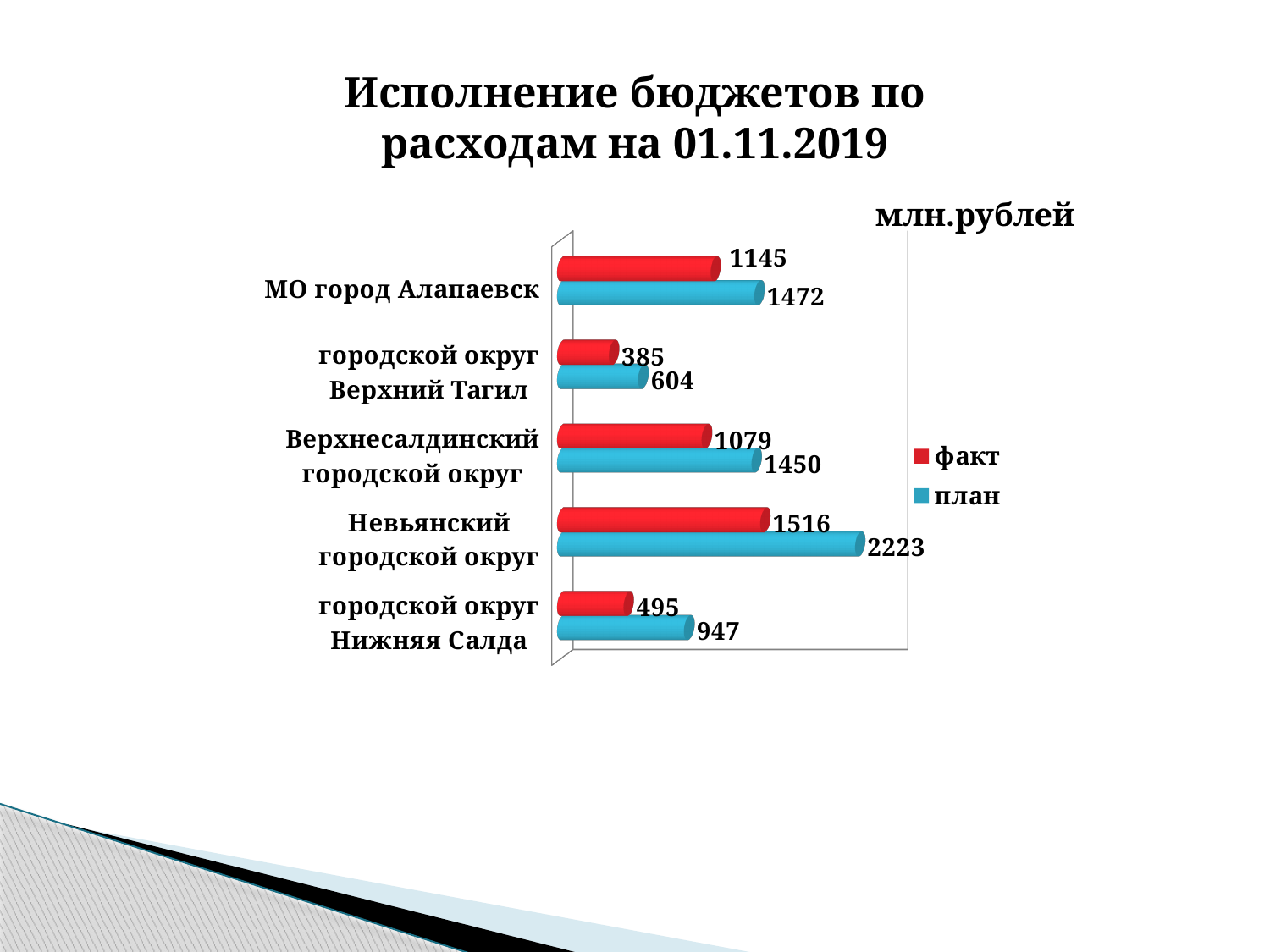
What unit is indicated above the chart? млн.рублей How many categories are shown on the chart? 5 What is the difference between the план and факт values for Верхнесалдинский городской округ? 371 Which category has the highest план value? Невьянский городской округ Which category has the lowest факт value? городской округ Верхний Тагил Which is larger: the факт value for МО город Алапаевск or the факт value for Верхнесалдинский городской округ? МО город Алапаевск What is the факт value for городской округ Нижняя Салда? 495 How many series does the legend list? 2 What kind of chart is shown on the slide? bar chart What is the план value for городской округ Верхний Тагил? 604 What is the факт value for МО город Алапаевск? 1145 What is the план value for Невьянский городской округ? 2223